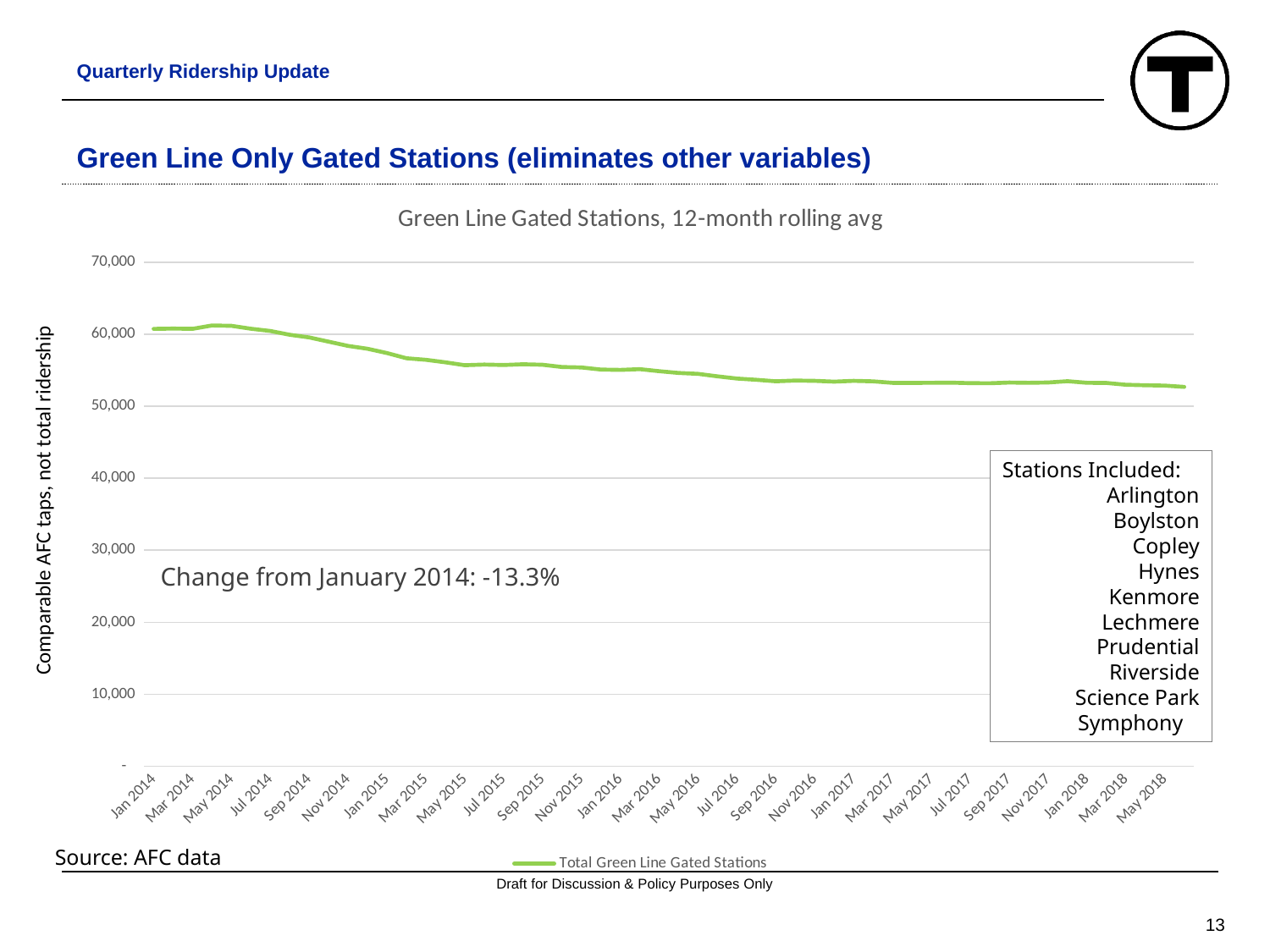
Do the values generally rise or fall from Jan 2014 to May 2018? fall What is the name of the series shown in the legend? Total Green Line Gated Stations Which is larger, the value for Jan 2014 or the value for May 2018? Jan 2014 Is the value for Jan 2014 greater or less than 70,000? less Is the value for Jan 2016 greater or less than 60,000? less Is the value for May 2014 greater or less than 60,000? greater How many series does the chart legend list? 1 What change from January 2014 is printed on the chart? -13.3% What kind of chart is shown on the slide? line chart What is the title of the chart? Green Line Gated Stations, 12-month rolling avg